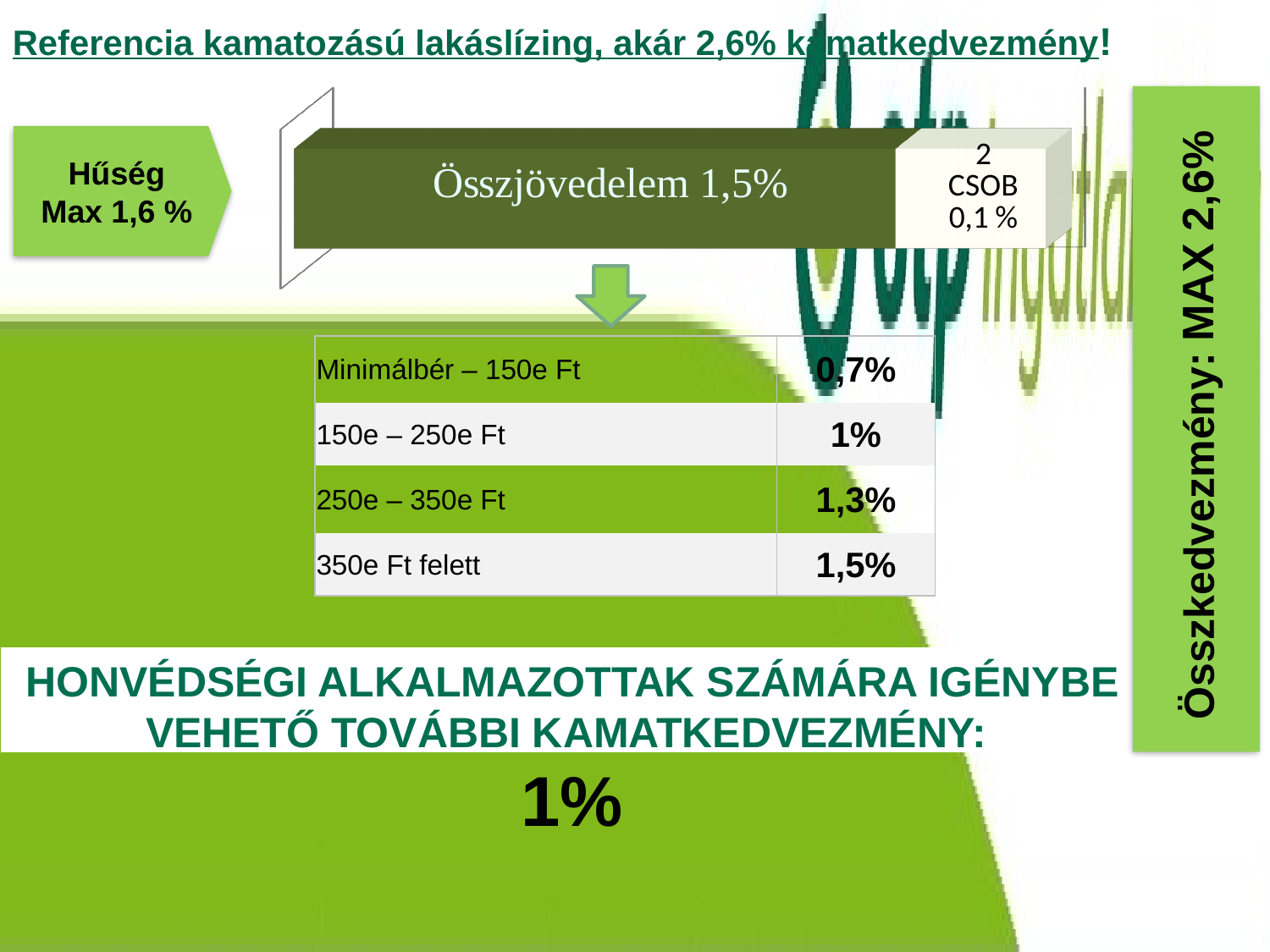
Which segment of the horizontal bar is larger, Összjövedelem or 2 CSOB? Összjövedelem What is the total of the two segments of the horizontal bar (Összjövedelem 1,5% and 2 CSOB 0,1 %)? 1,6% In the table below the bar, what value is shown for the row 350e Ft felett? 1,5% What kind of chart is the horizontal graphic at the top of the slide showing Összjövedelem and 2 CSOB? bar chart What is the difference between the Összjövedelem segment (1,5%) and the 2 CSOB segment (0,1 %) of the horizontal bar? 1,4% What value is printed on the dark green segment of the horizontal bar labelled Összjövedelem? 1,5% What value is printed on the light segment of the horizontal bar labelled 2 CSOB? 0,1 % In the table below the bar, do the values rise or fall as income increases from Minimálbér – 150e Ft to 350e Ft felett? rise In the table below the bar, which income row has the lowest value? Minimálbér – 150e Ft What maximum total discount is stated on the vertical green banner on the right of the slide? MAX 2,6% How many segments does the horizontal bar at the top of the slide have? 2 In the table below the bar, what value is shown for the row Minimálbér – 150e Ft? 0,7%